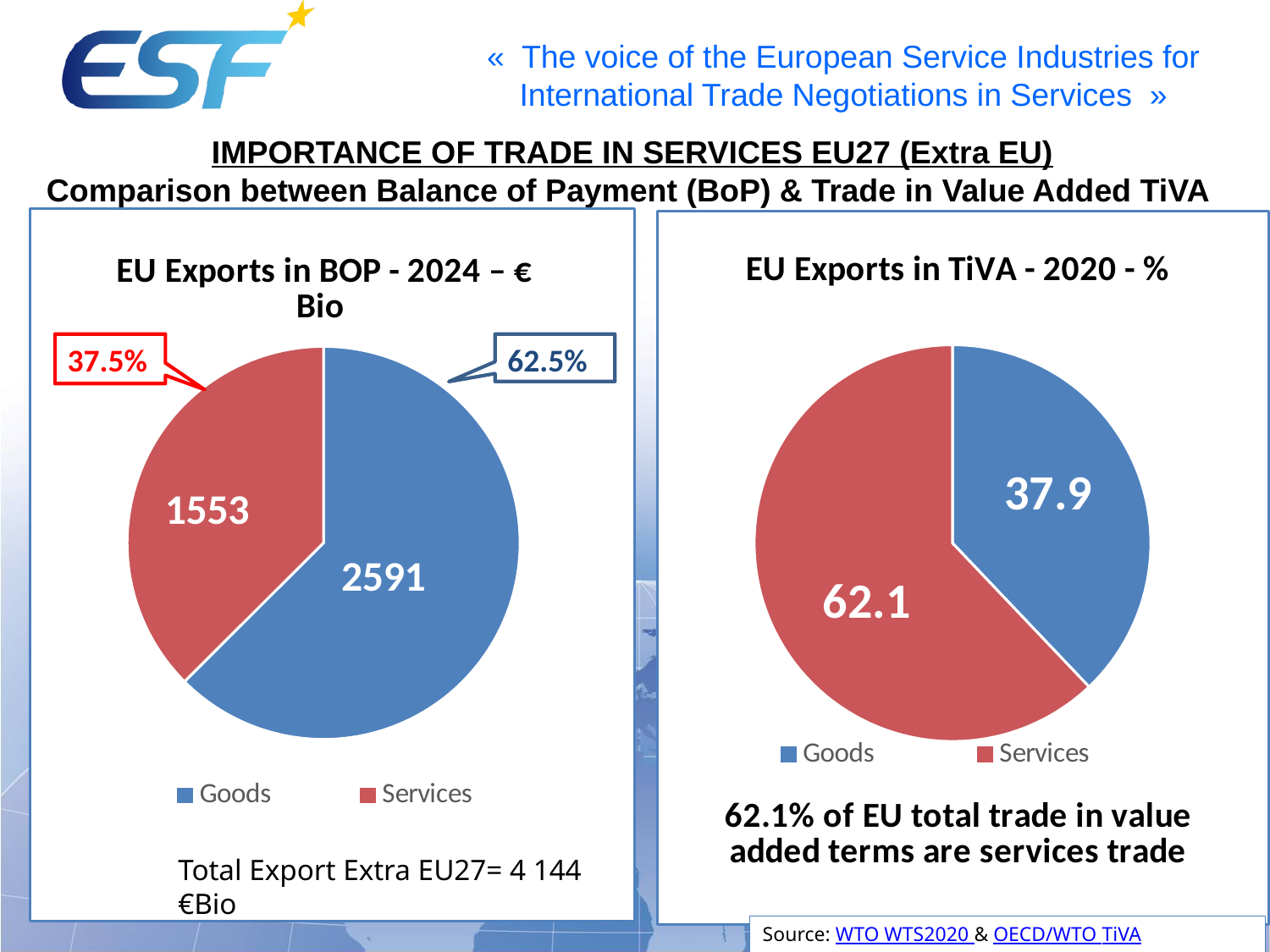
In the 'EU Exports in BOP - 2024' chart, what percentage share is shown for Goods? 62.5% In the 'EU Exports in TiVA - 2020' chart, what is the difference between the Services and Goods values? 24.2 In the 'EU Exports in BOP - 2024' chart, what is the value for Services? 1553 In the 'EU Exports in TiVA - 2020' chart, what is the value for Services? 62.1 How many categories does the legend of the 'EU Exports in BOP - 2024' chart list? 2 In the 'EU Exports in BOP - 2024' chart, what percentage share is shown for Services? 37.5% In the 'EU Exports in BOP - 2024' chart, what is the value for Goods? 2591 In the 'EU Exports in BOP - 2024' chart, which category has the larger value, Goods or Services? Goods What type of chart is the 'EU Exports in TiVA - 2020' chart? Pie chart In the 'EU Exports in TiVA - 2020' chart, which category is the largest? Services In the 'EU Exports in TiVA - 2020' chart, what is the value for Goods? 37.9 In the 'EU Exports in BOP - 2024' chart, what is the difference between the Goods and Services values? 1038